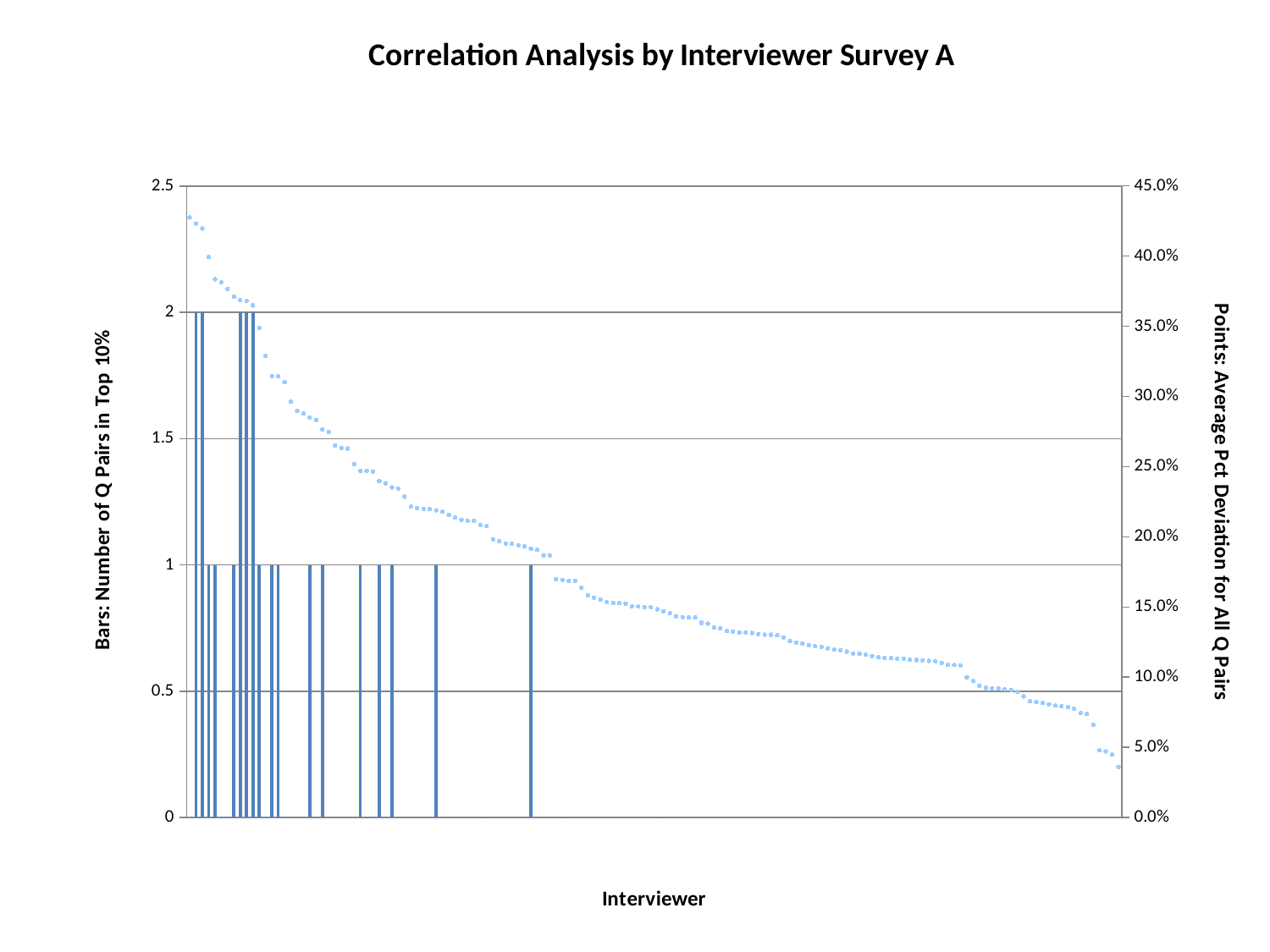
Do the plotted points rise or fall from left to right along the x axis? Fall What is the title of the chart? Correlation Analysis by Interviewer Survey A What kind of chart is this? Combined bar chart and scatter plot Is the value of the leftmost point greater or less than 40.0%? greater How many bars reach the value 2? 5 What is the title of the right-hand vertical axis? Points: Average Pct Deviation for All Q Pairs Which is higher, the leftmost point or the rightmost point? The leftmost point Is the value of the tallest bar greater or less than 2.5? less Is the value of the rightmost point greater or less than 5.0%? less What is the smallest non-zero bar height shown on the left axis? 1 What is the highest value reached by any bar on the left axis? 2